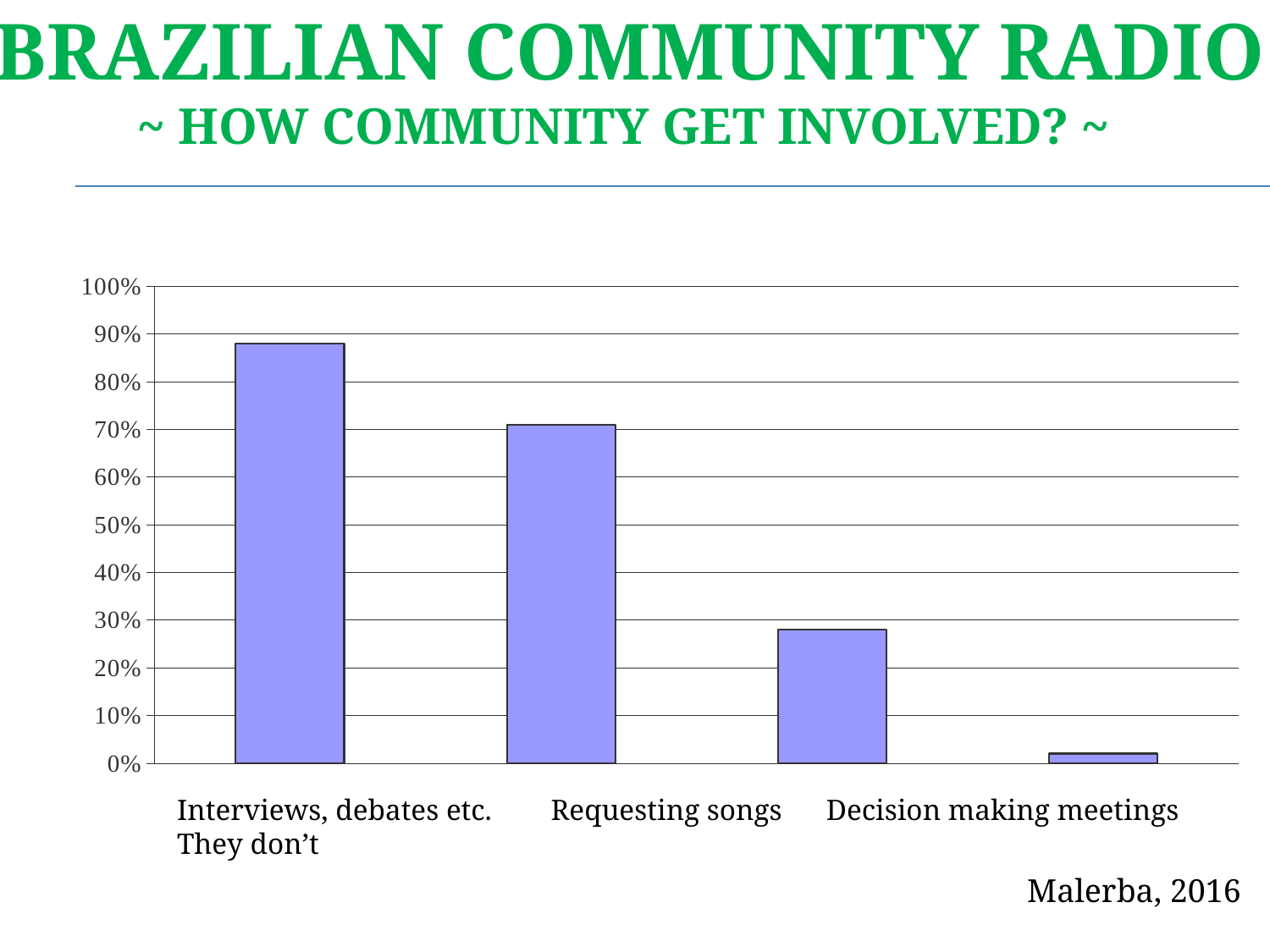
What kind of chart is shown on the slide? Bar chart What is the maximum value shown on the vertical axis? 100% Is the value for Decision making meetings greater or less than 20%? greater Is the value for Interviews, debates etc. greater or less than 80%? greater Which category has the lowest value? They don't Which is larger, the value for Requesting songs or the value for Decision making meetings? Requesting songs How many categories (bars) does the chart show? 4 Do the bar values rise or fall from left to right across the chart? Fall What source is cited below the chart? Malerba, 2016 Which category has the highest value? Interviews, debates etc. Is the value for They don't greater or less than 10%? less